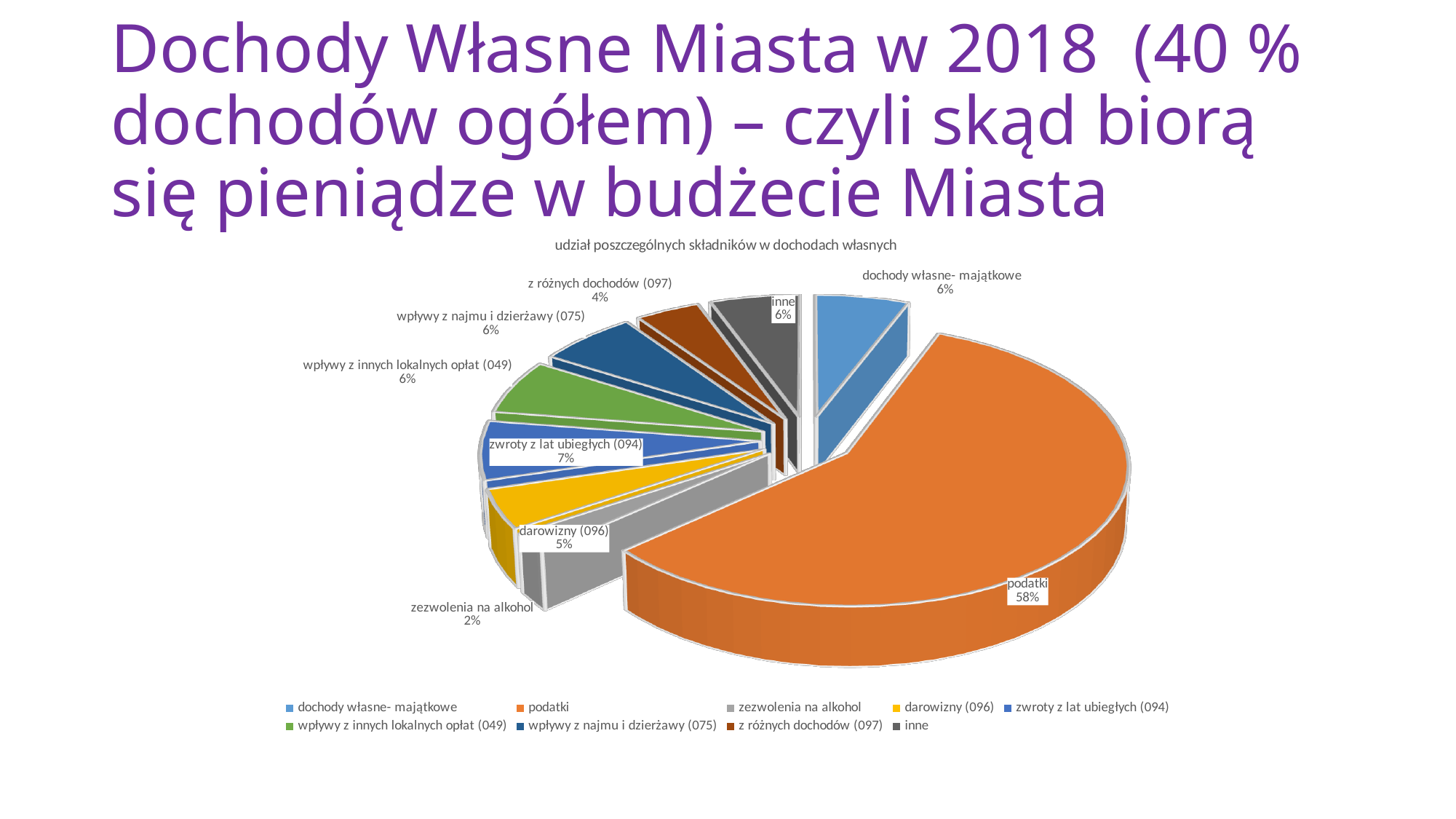
How many categories does the legend list? 9 What is the value shown for 'darowizny (096)'? 5% Which is larger, the share of 'darowizny (096)' or the share of 'zwroty z lat ubiegłych (094)'? zwroty z lat ubiegłych (094) What share of the pie does 'podatki' represent? 58% What is the difference between the share of 'podatki' and the share of 'zwroty z lat ubiegłych (094)'? 51% Which category has the smallest share of the pie? zezwolenia na alkohol What is the value shown for 'z różnych dochodów (097)'? 4% What type of chart is shown on the slide? pie chart What is the value shown for 'zwroty z lat ubiegłych (094)'? 7% What is the value shown for 'zezwolenia na alkohol'? 2% Which category has the largest share of the pie? podatki What is the title of the chart? udział poszczególnych składników w dochodach własnych